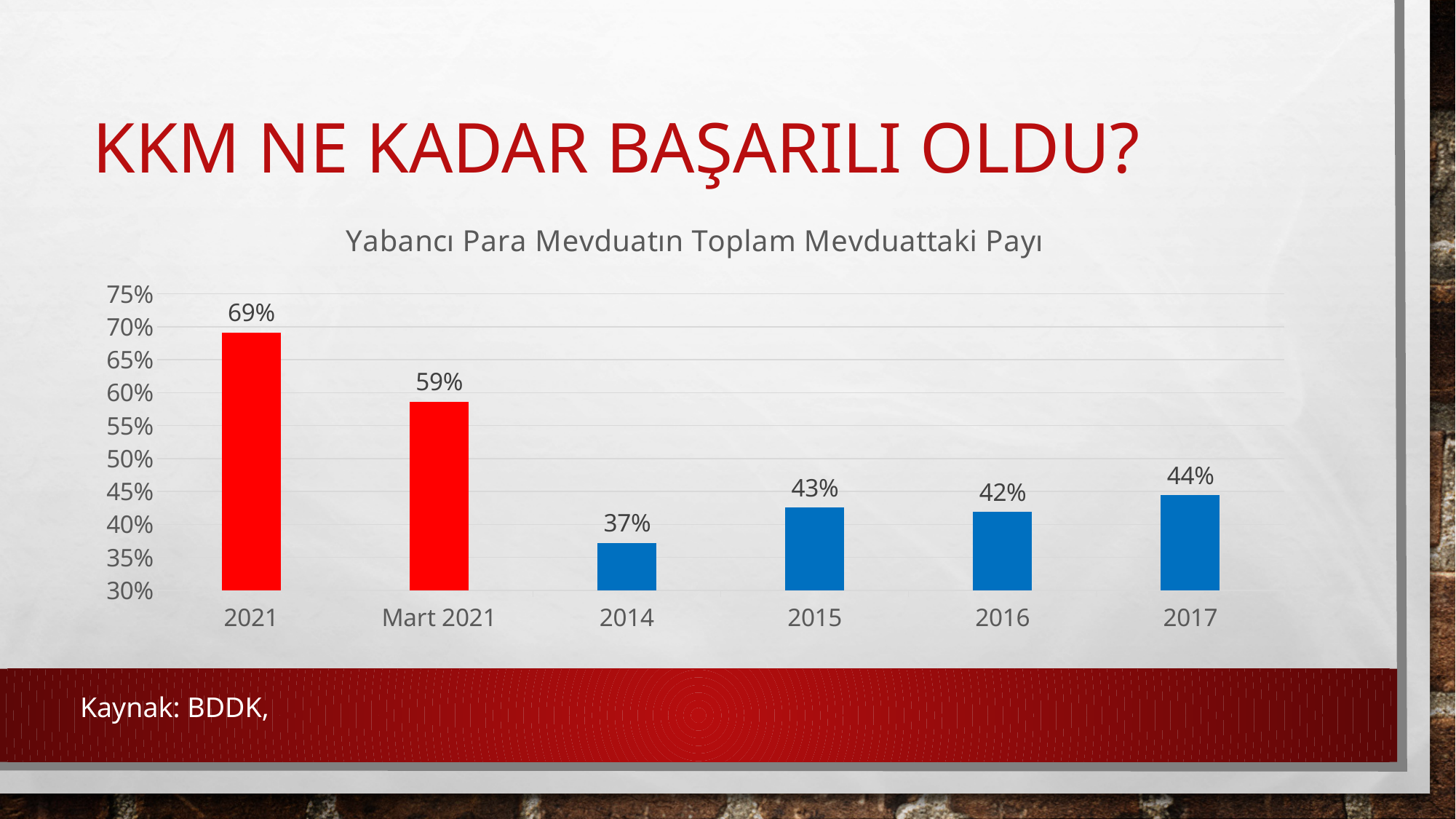
What is the difference between the values for 2017 and 2014? 7% What is the value for 2021? 69% Which category has the highest value? 2021 What is the difference between the values for 2021 and Mart 2021? 10% Which category has the lowest value? 2014 What kind of chart is shown? Bar chart What is the value for 2017? 44% What is the title of the chart? Yabancı Para Mevduatın Toplam Mevduattaki Payı What is the value for Mart 2021? 59% What is the value for 2014? 37% How many categories are shown on the x axis? 6 Which is larger, the value for 2015 or the value for 2016? 2015